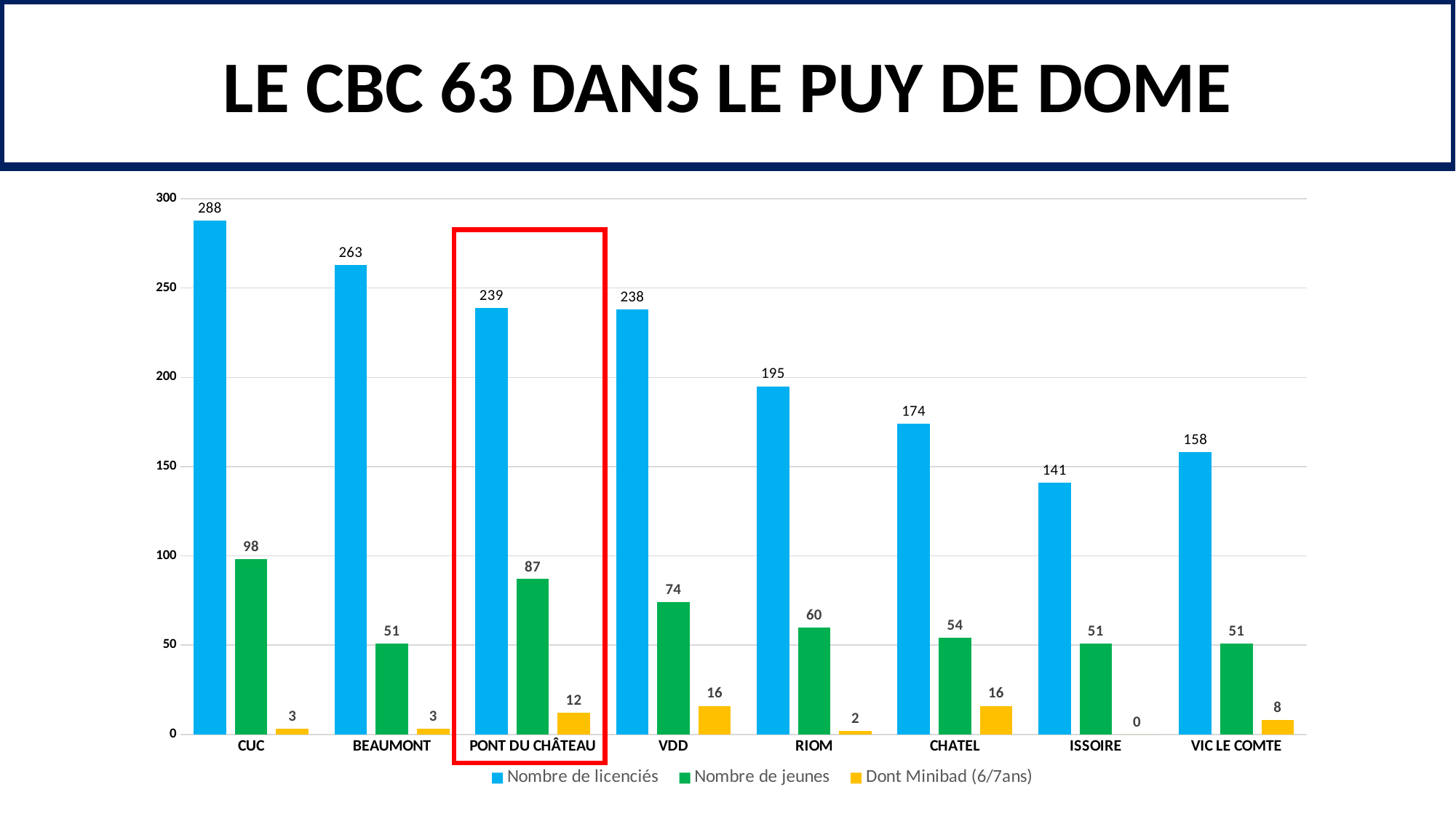
Which category has the highest Nombre de licenciés? CUC How many series does the legend list? 3 Which category has the lowest Nombre de licenciés? ISSOIRE How many categories are shown on the x axis? 8 What is the difference between the Nombre de licenciés for CUC and BEAUMONT? 25 What is the value of Nombre de licenciés for PONT DU CHÂTEAU? 239 What is the value of Nombre de jeunes for VDD? 74 Which category has the lowest Dont Minibad (6/7ans) value? ISSOIRE Which is larger, the Nombre de jeunes for RIOM or for CHATEL? RIOM What is the value of Dont Minibad (6/7ans) for CHATEL? 16 Which category is highlighted with a red box? PONT DU CHÂTEAU What kind of chart is shown on the slide? Bar chart